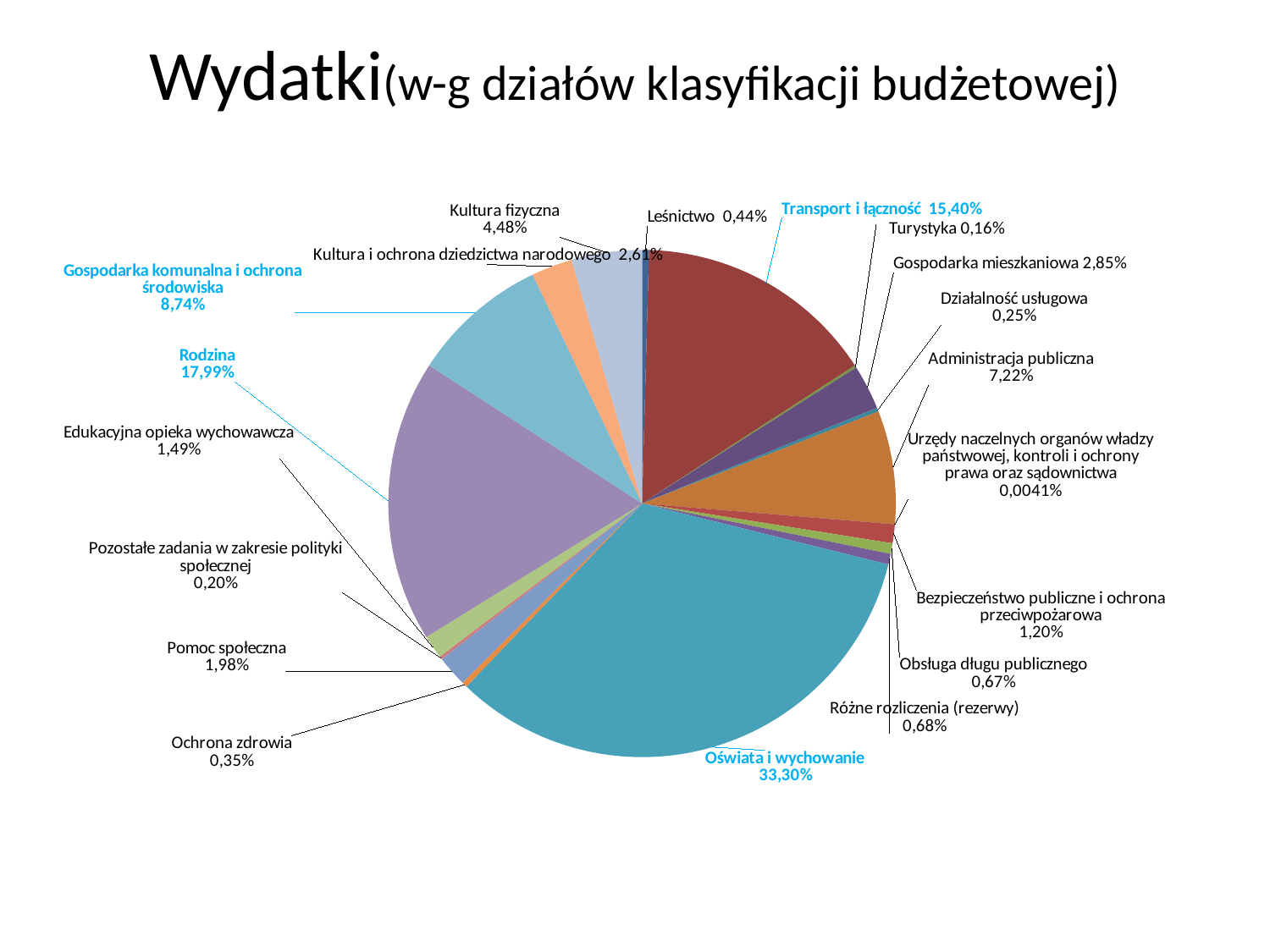
What is the value shown for Transport i łączność? 15,40% What is the title of the slide? Wydatki (w-g działów klasyfikacji budżetowej) What is the value shown for Gospodarka komunalna i ochrona środowiska? 8,74% Which is larger, the share for Kultura fizyczna or the share for Gospodarka mieszkaniowa? Kultura fizyczna How many categories are shown in the pie chart? 19 What share of expenditure goes to Oświata i wychowanie? 33,30% Which category has the smallest share of the pie? Urzędy naczelnych organów władzy państwowej, kontroli i ochrony prawa oraz sądownictwa What kind of chart is shown on the slide? pie chart What is the value shown for Administracja publiczna? 7,22% What is the difference between the shares of Rodzina and Transport i łączność? 2,59% What is the value shown for Rodzina? 17,99% Which category has the largest share of the pie? Oświata i wychowanie